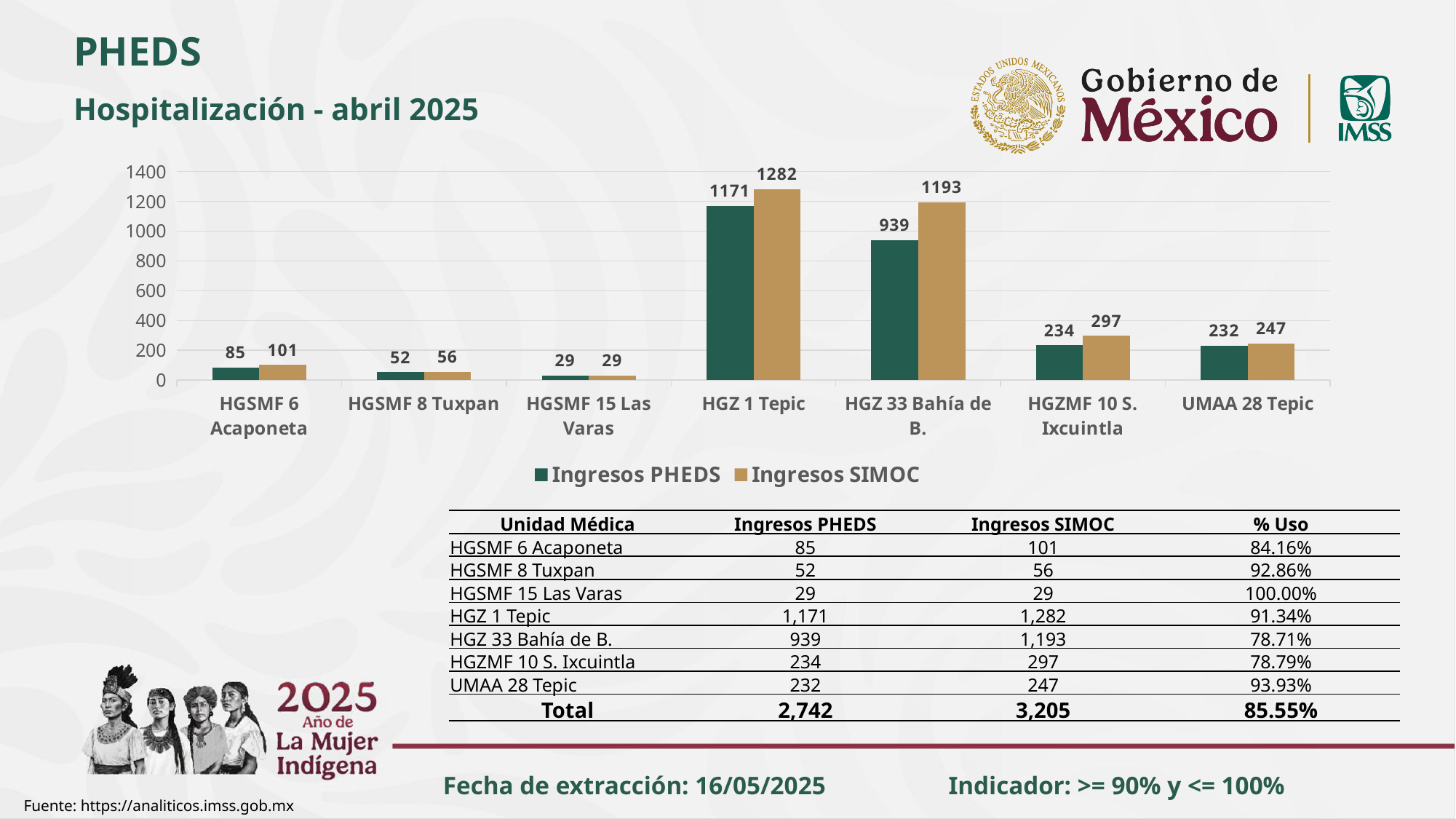
Which category has the highest Ingresos SIMOC value? HGZ 1 Tepic How many categories are shown on the x axis of the chart? 7 What is the Ingresos SIMOC value for HGSMF 6 Acaponeta? 101 What is the difference between Ingresos SIMOC and Ingresos PHEDS for HGZ 33 Bahía de B.? 254 Is the Ingresos PHEDS value for HGZ 33 Bahía de B. greater or less than 1000? less What is the Ingresos PHEDS value for HGZ 1 Tepic? 1171 Which is larger for HGZMF 10 S. Ixcuintla, Ingresos PHEDS or Ingresos SIMOC? Ingresos SIMOC Which category has the lowest Ingresos PHEDS value? HGSMF 15 Las Varas What is the Ingresos SIMOC value for HGZ 33 Bahía de B.? 1193 What kind of chart is shown on the slide? bar chart How many series does the chart legend list? 2